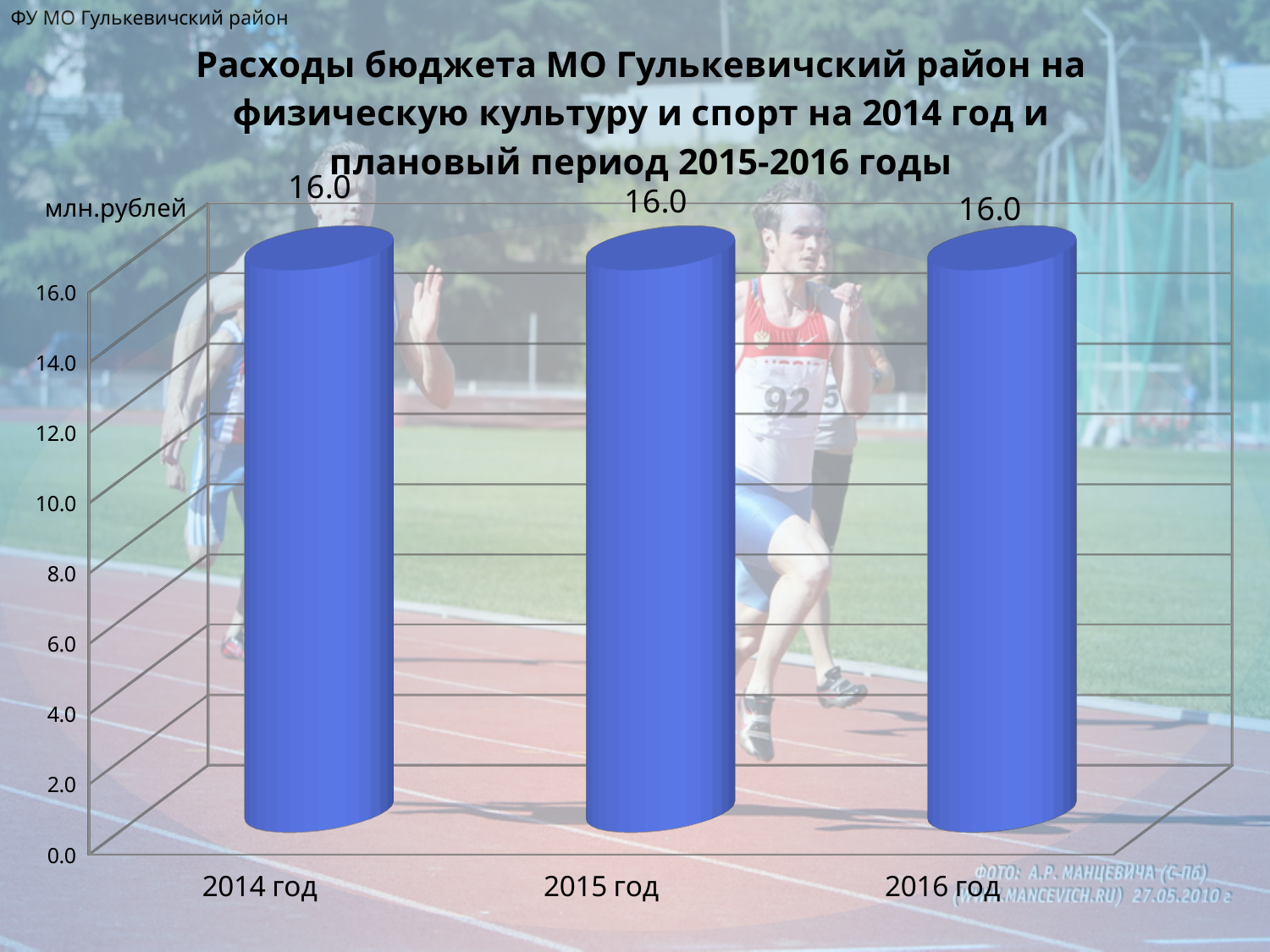
What is the title of the chart? Расходы бюджета МО Гулькевичский район на физическую культуру и спорт на 2014 год и плановый период 2015-2016 годы What unit is shown for the values on the chart? млн.рублей What is the value for 2014 год? 16.0 What is the value for 2015 год? 16.0 What kind of chart is shown on the slide? bar chart Do the values rise, fall or stay the same from 2014 год to 2016 год? stay the same What is the value for 2016 год? 16.0 How many categories are shown on the x axis? 3 Is the value for 2015 год greater or less than 10.0? greater What is the difference between the values for 2014 год and 2016 год? 0.0